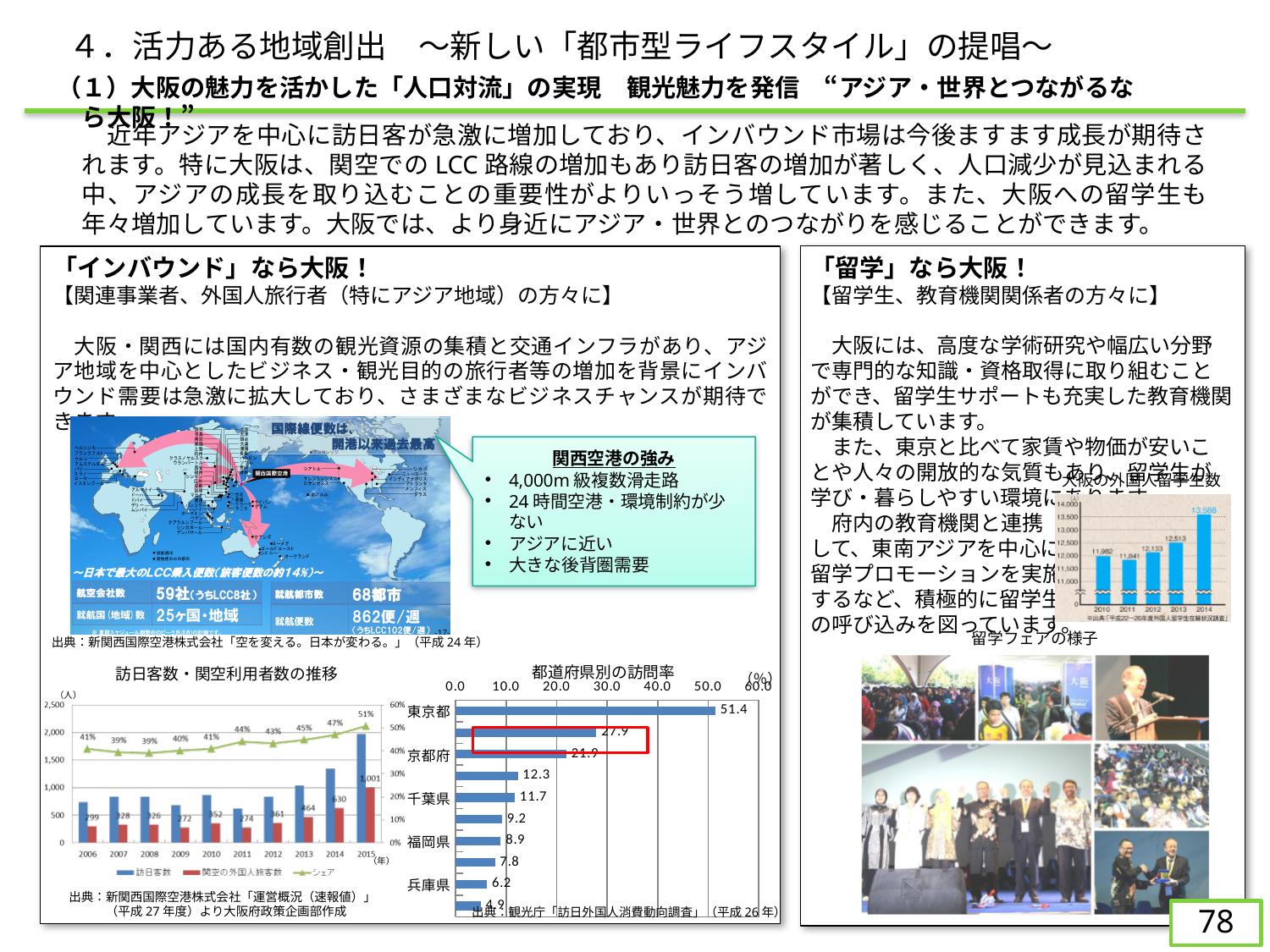
In the chart titled 都道府県別の訪問率, what kind of chart is it? bar chart In the chart titled 大阪の外国人留学生数, what is the value for 2014? 13,588 In the chart titled 訪日客数・関空利用者数の推移, what is the シェア value for 2006? 41% In the chart titled 訪日客数・関空利用者数の推移, what is the value of 関空の外国人旅客数 for 2015? 1,001 In the chart titled 訪日客数・関空利用者数の推移, how many series does the legend list? 3 In the chart titled 都道府県別の訪問率, what is the value for 京都府? 21.9 In the chart titled 訪日客数・関空利用者数の推移, is the 訪日客数 value for 2015 greater or less than 1,500? greater In the chart titled 都道府県別の訪問率, which has a larger value, 千葉県 or 兵庫県? 千葉県 In the chart titled 訪日客数・関空利用者数の推移, how many years are shown on the x axis? 10 In the chart titled 都道府県別の訪問率, which prefecture has the highest visit rate? 東京都 In the chart titled 都道府県別の訪問率, what is the difference between the values for 東京都 and 京都府? 29.5 In the chart titled 都道府県別の訪問率, what is the value for 東京都? 51.4